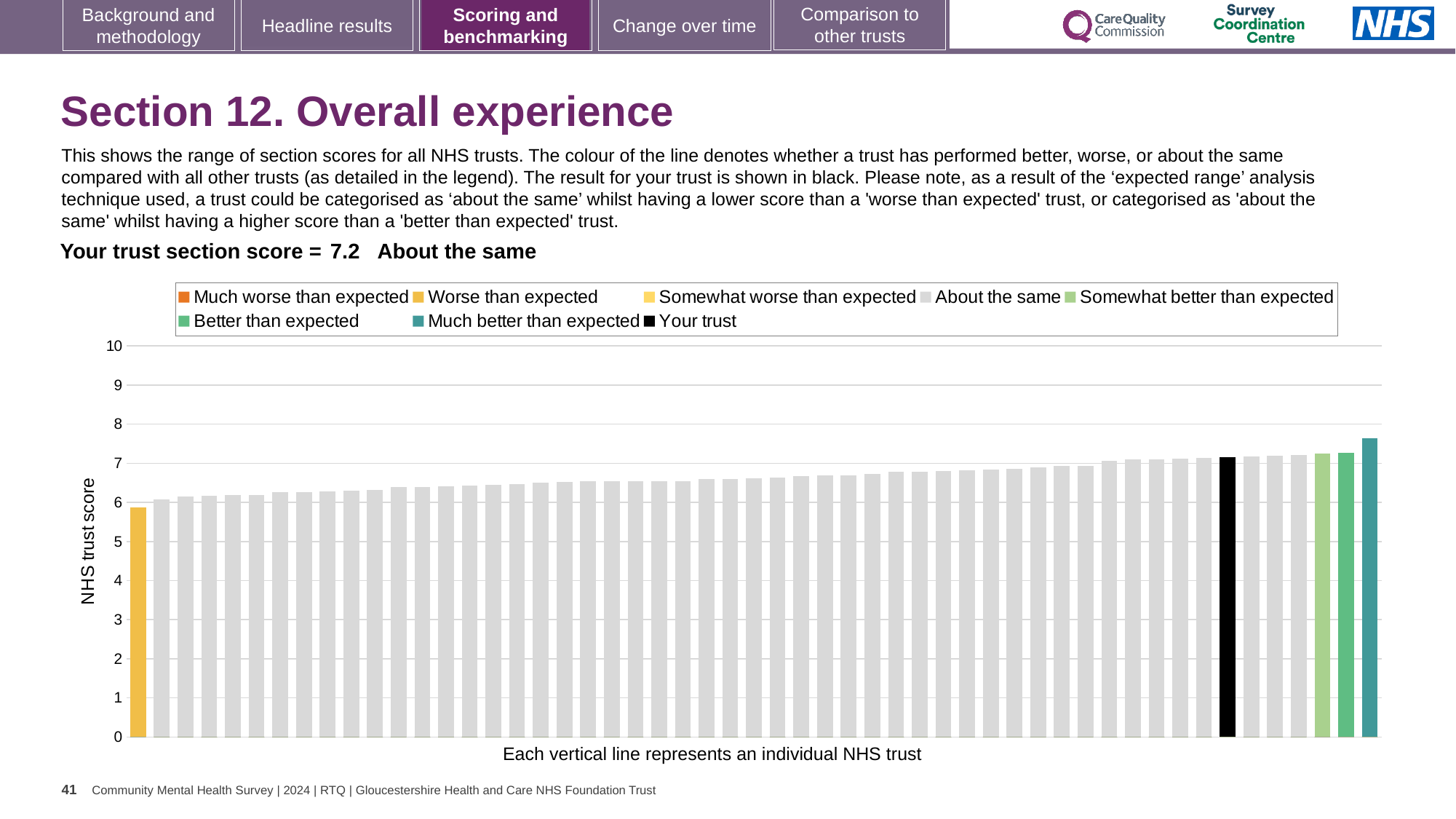
Is the value of the leftmost (yellow) bar greater or less than 6? less How many entries does the chart legend list? 8 What is the label of the y axis? NHS trust score Is the value of the black 'Your trust' bar greater or less than 7? greater How is your trust's section score categorised compared with other trusts? About the same Is the value of the rightmost (teal) bar greater or less than 7? greater What is the section score for your trust shown on the slide? 7.2 Do the bar values rise or fall from left to right along the x axis? rise Which bar is the highest on the chart: the black 'Your trust' bar or the rightmost teal bar? the rightmost teal bar What colour is used for the 'Your trust' bar in the legend? black How many bars are coloured as 'Worse than expected' (yellow)? 1 What kind of chart is shown on the slide? bar chart